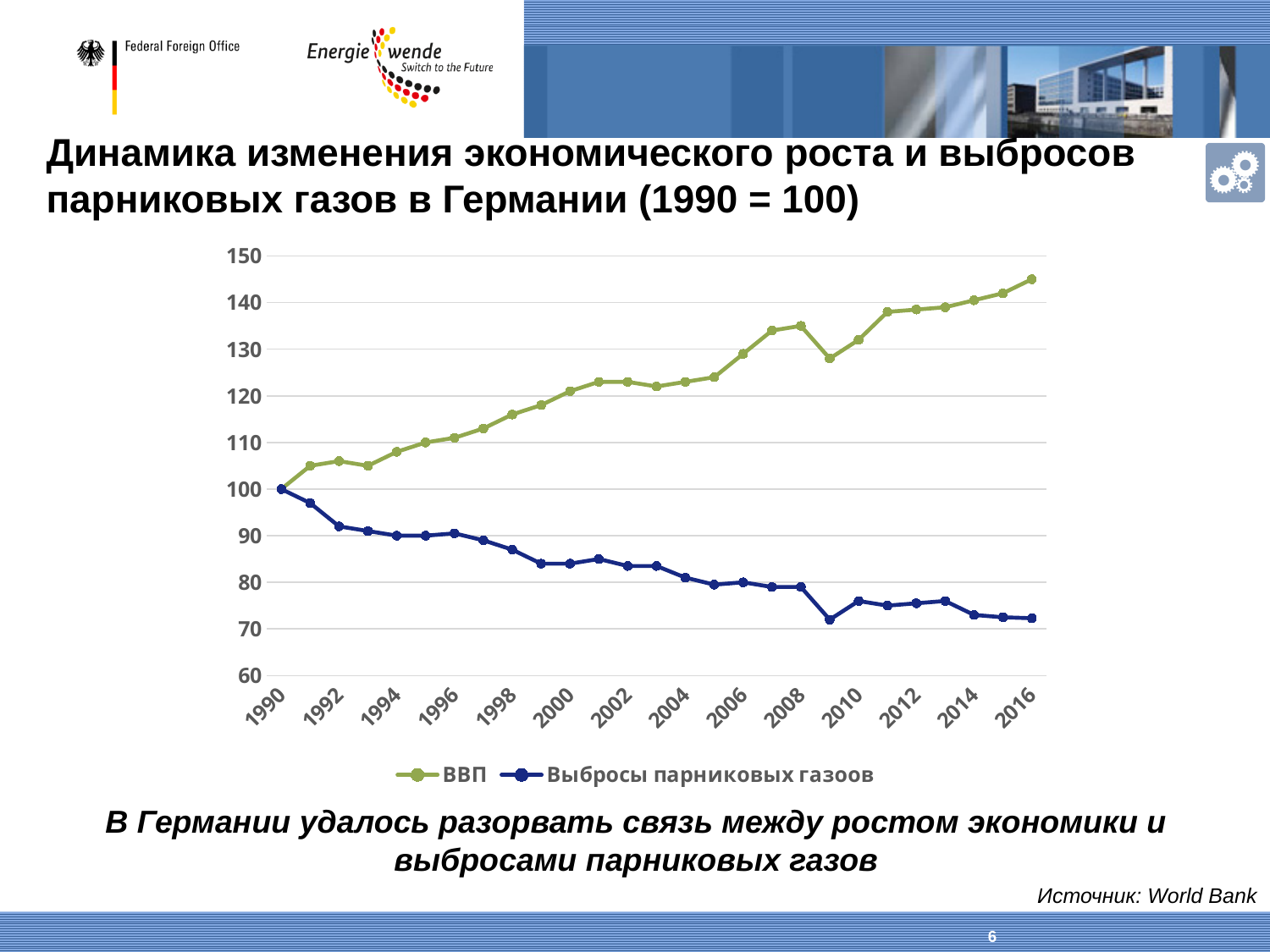
What kind of chart is shown on the slide? line chart Does ВВП generally rise or fall from 1990 to 2016? rise How many series does the legend list? 2 What are the two series named in the legend? ВВП and Выбросы парниковых газоов What is the value of Выбросы парниковых газов in 1990? 100 Do Выбросы парниковых газов generally rise or fall from 1990 to 2016? fall Is the value for Выбросы парниковых газов in 2016 greater or less than 80? less What is the value of ВВП in 1990? 100 Which series has the larger value in 2008, ВВП or Выбросы парниковых газов? ВВП Is the value for ВВП in 2016 greater or less than 140? greater In which year is ВВП highest? 2016 Is the value for ВВП in 2009 greater or less than 130? less